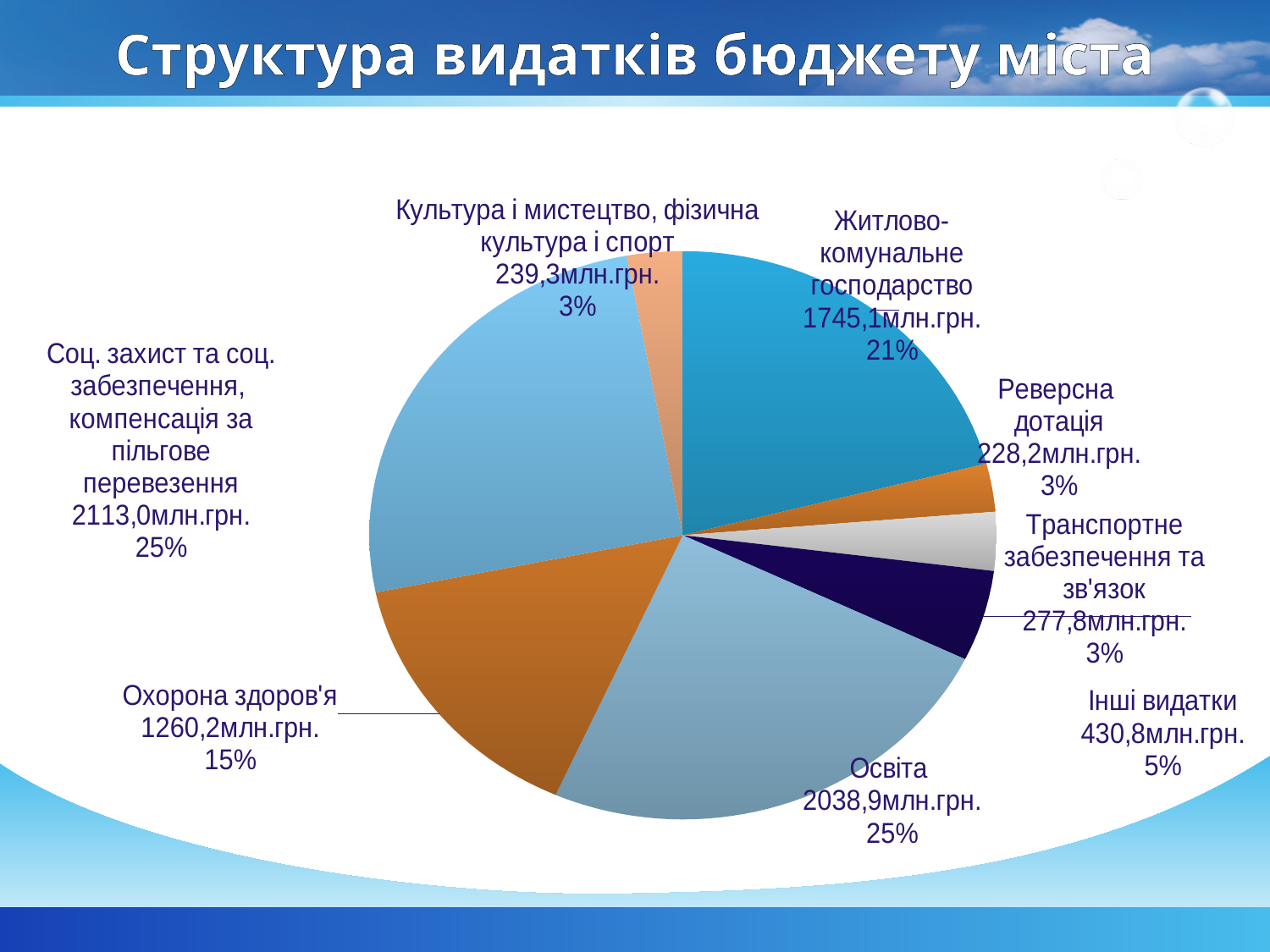
What is the title of the chart? Структура видатків бюджету міста Which category has the smallest value? Реверсна дотація What share of the pie does Інші видатки represent? 5% What kind of chart is shown on the slide? Pie chart Which category has the largest value in млн.грн.? Соц. захист та соц. забезпечення, компенсація за пільгове перевезення How many categories (slices) does the pie chart show? 8 What is the value for Охорона здоров'я? 1260,2млн.грн. What is the value for Освіта? 2038,9млн.грн. What is the value for Житлово-комунальне господарство? 1745,1млн.грн. What is the difference between the values for Освіта and Охорона здоров'я? 778,7млн.грн. Which is larger: Транспортне забезпечення та зв'язок or Реверсна дотація? Транспортне забезпечення та зв'язок What share of the pie does Житлово-комунальне господарство represent? 21%